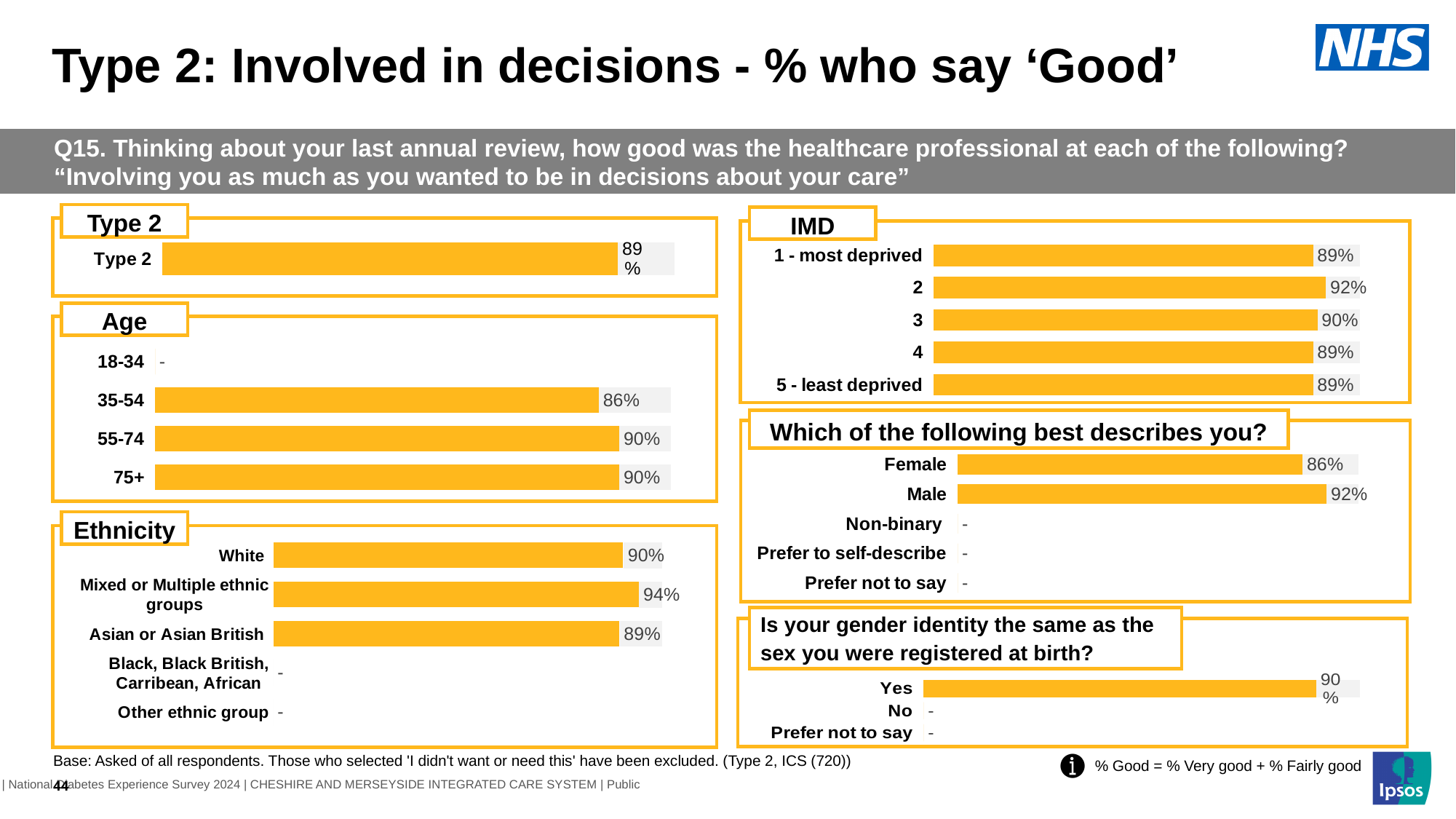
How many categories are listed in the IMD chart? 5 In the IMD chart, what is the value for 3? 90% In the Ethnicity chart, what is the difference between Mixed or Multiple ethnic groups and White? 4% In the Age chart, which age group has the lowest value among those with a bar? 35-54 In the Age chart, what is the value for 35-54? 86% In the 'Which of the following best describes you?' chart, which is larger, Female or Male? Male In the IMD chart, which IMD group has the highest value? 2 In the 'Is your gender identity the same as the sex you were registered at birth?' chart, what is the value for Yes? 90% In the 'Which of the following best describes you?' chart, what is the difference between Male and Female? 6% In the Type 2 chart, what is the value for Type 2? 89% In the Ethnicity chart, which ethnic group has the highest value? Mixed or Multiple ethnic groups What kind of chart is the Age chart? Bar chart